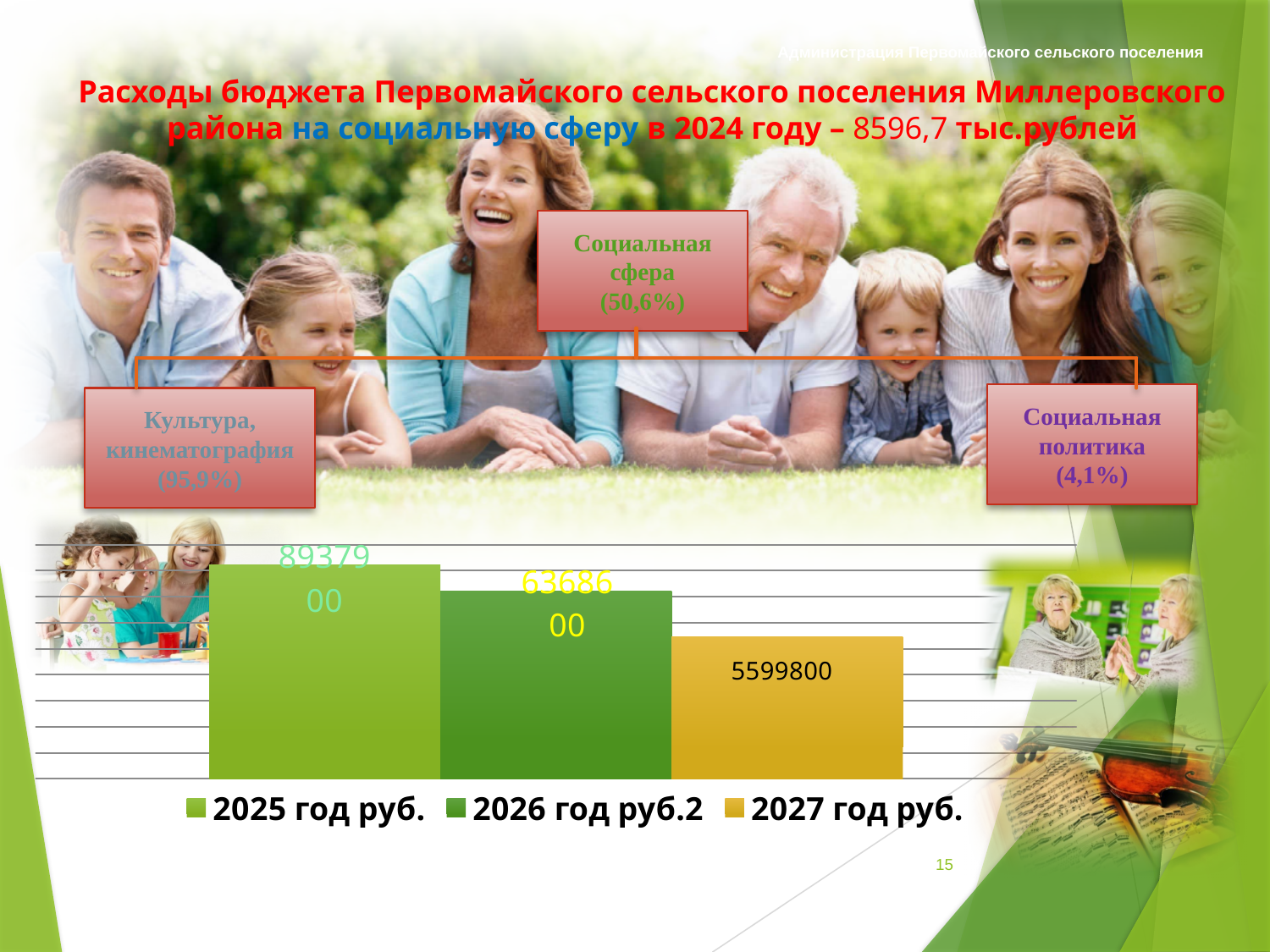
What is the value shown for the 2027 год руб. bar? 5599800 Which series has the highest value in the chart? 2025 год руб. How many bars are plotted in the chart? 3 How many series does the chart legend list? 3 What is the difference between the 2026 год руб.2 value and the 2027 год руб. value? 768800 What kind of chart is shown on the slide? bar chart What is the value shown for the 2025 год руб. bar? 8937900 Do the bar values rise or fall from left to right across the chart? fall Which is larger, the value for 2026 год руб.2 or the value for 2027 год руб.? 2026 год руб.2 What is the value shown for the 2026 год руб.2 bar? 6368600 Which series has the lowest value in the chart? 2027 год руб. What is the difference between the 2025 год руб. value and the 2027 год руб. value? 3338100